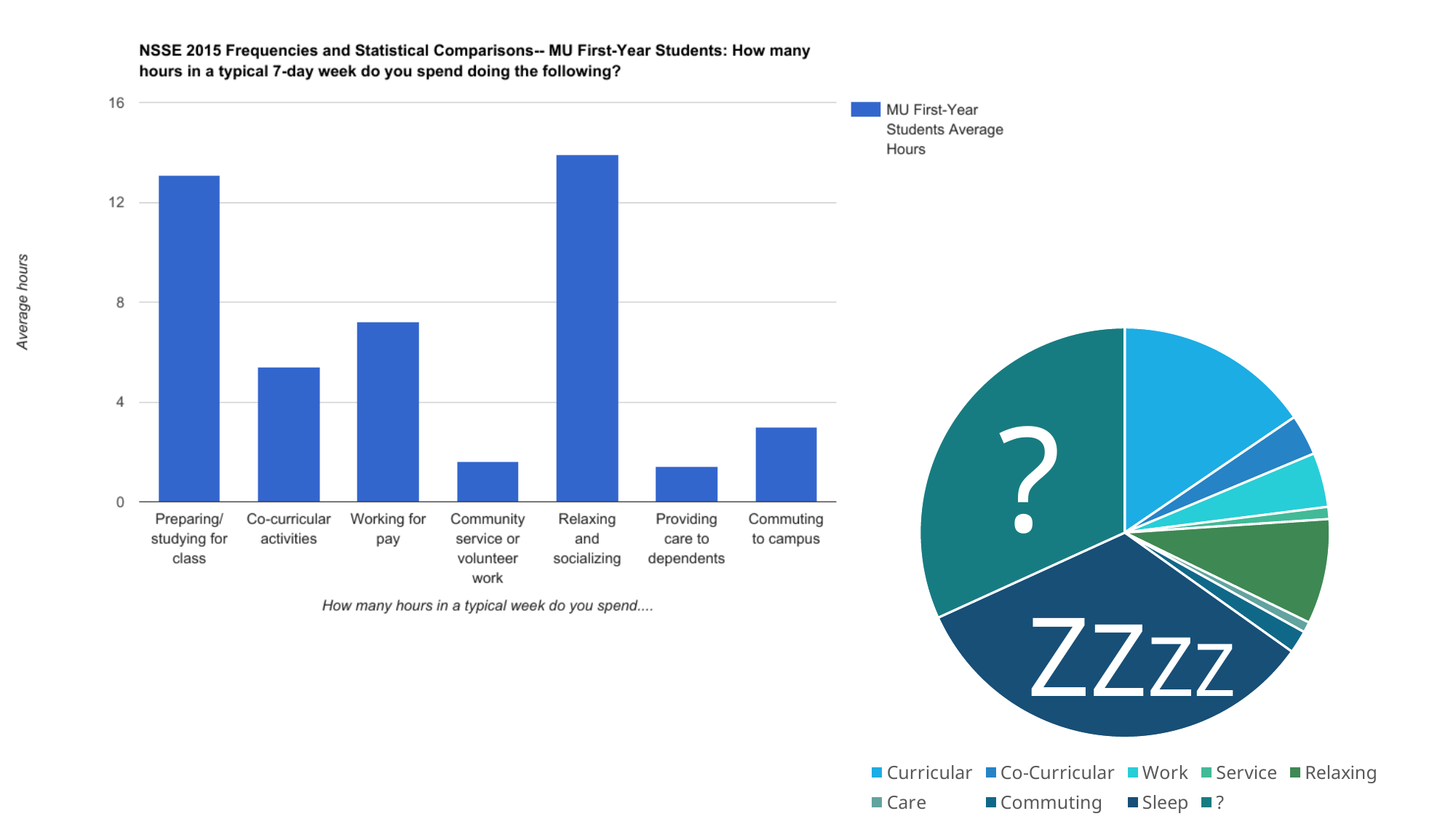
In the NSSE 2015 bar chart, how many activity categories are shown on the x axis? 7 In the NSSE 2015 bar chart, which is larger: Commuting to campus or Community service or volunteer work? Commuting to campus In the NSSE 2015 bar chart, is the value for Co-curricular activities greater or less than 4? greater What kind of chart is shown on the right of the slide? pie chart In the NSSE 2015 bar chart, which activity has the highest average hours? Relaxing and socializing How many series does the legend of the NSSE 2015 bar chart list? 1 How many categories does the legend of the pie chart on the right list? 9 In the NSSE 2015 bar chart, which is larger: Working for pay or Co-curricular activities? Working for pay In the NSSE 2015 bar chart, is the value for Working for pay greater or less than 8? less In the NSSE 2015 bar chart, is the value for Preparing/studying for class greater or less than 12? greater What kind of chart is the NSSE 2015 chart on the left of the slide? bar chart